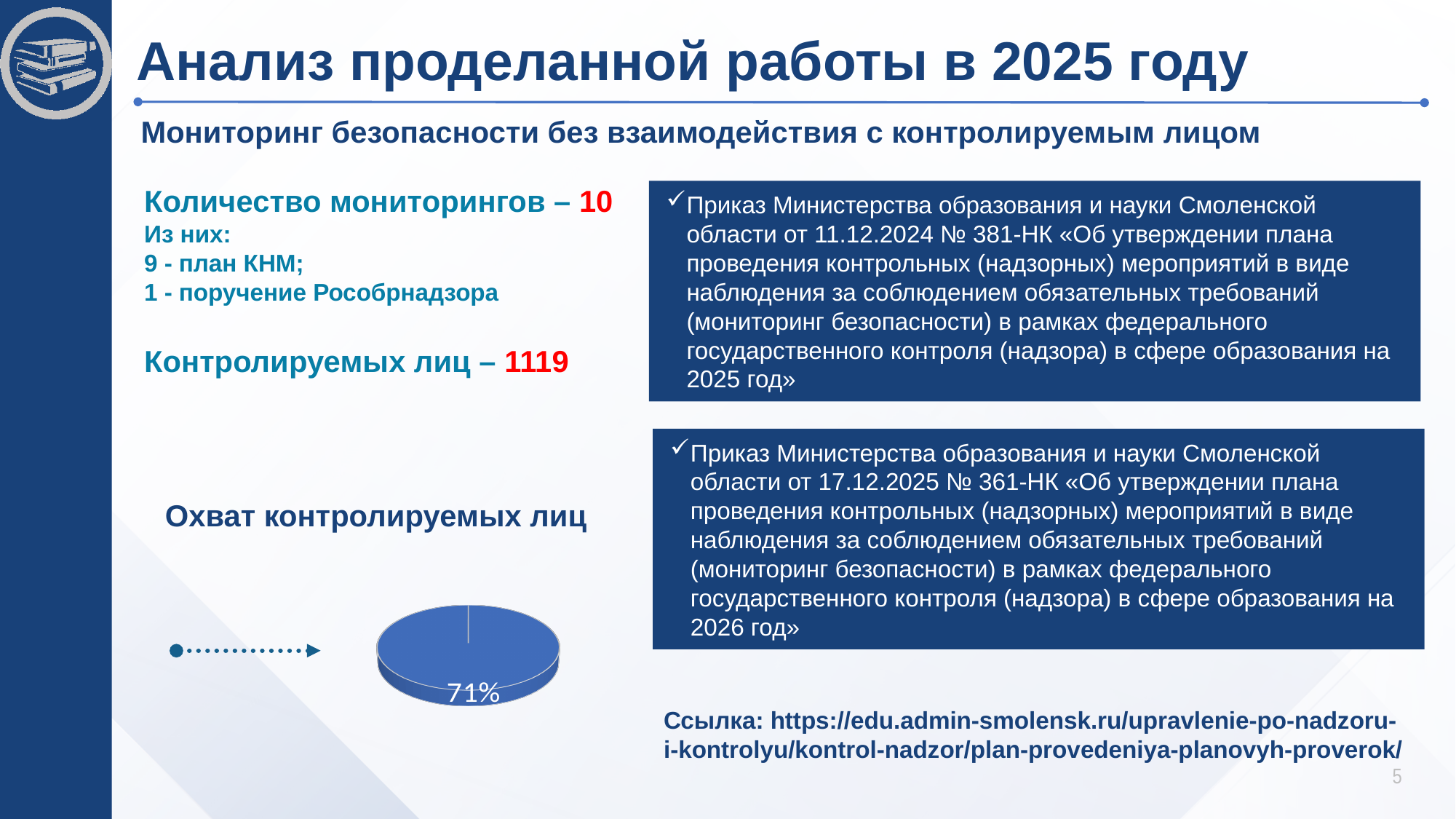
What kind of chart is shown under the heading "Охват контролируемых лиц"? pie chart How many data labels are printed on the pie chart? 1 What percentage value is printed on the pie chart? 71% What colour is the pie chart? blue What is the title of the pie chart on the slide? Охват контролируемых лиц Is the value labelled on the pie chart greater or less than 50%? greater